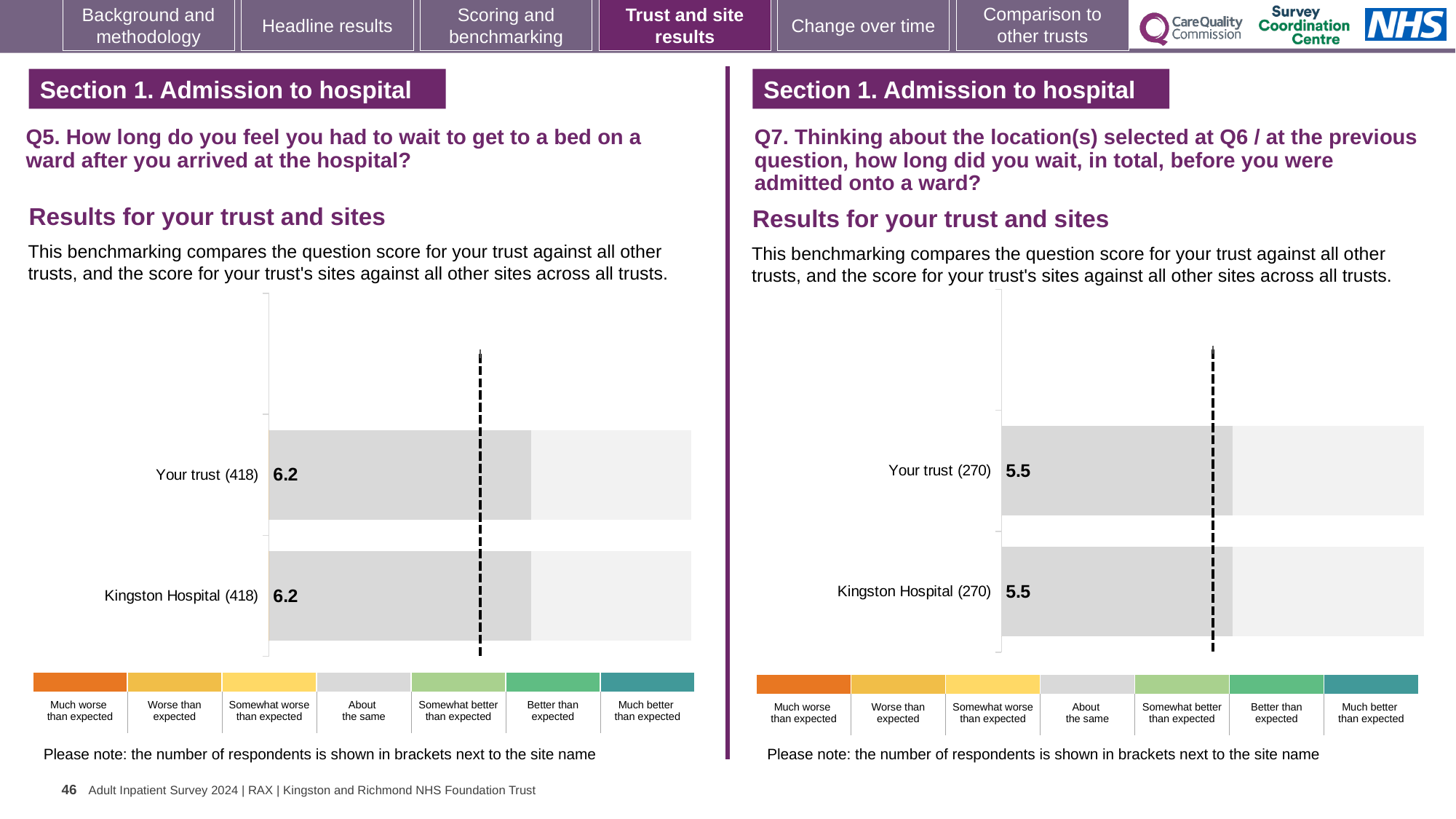
In the Q7 chart on the right, how many respondents are shown in brackets next to Kingston Hospital? 270 How many bars are plotted in the Q5 chart on the left? 2 In the Q5 chart on the left, what is the difference between the score for Your trust and the score for Kingston Hospital? 0 In the Q7 chart on the right, what is the score for Your trust? 5.5 In the Q7 chart on the right, what is the score for Kingston Hospital? 5.5 How many benchmark categories does the colour key below the Q7 chart on the right list? 7 What kind of chart is used for the Q5 results on the left? Bar chart In the Q5 chart on the left, how many respondents are shown in brackets next to Your trust? 418 In the Q7 chart on the right, what is the difference between the score for Your trust and the score for Kingston Hospital? 0 How many bars are plotted in the Q7 chart on the right? 2 In the Q5 chart on the left, what is the score for Kingston Hospital? 6.2 In the Q5 chart on the left, what is the score for Your trust? 6.2